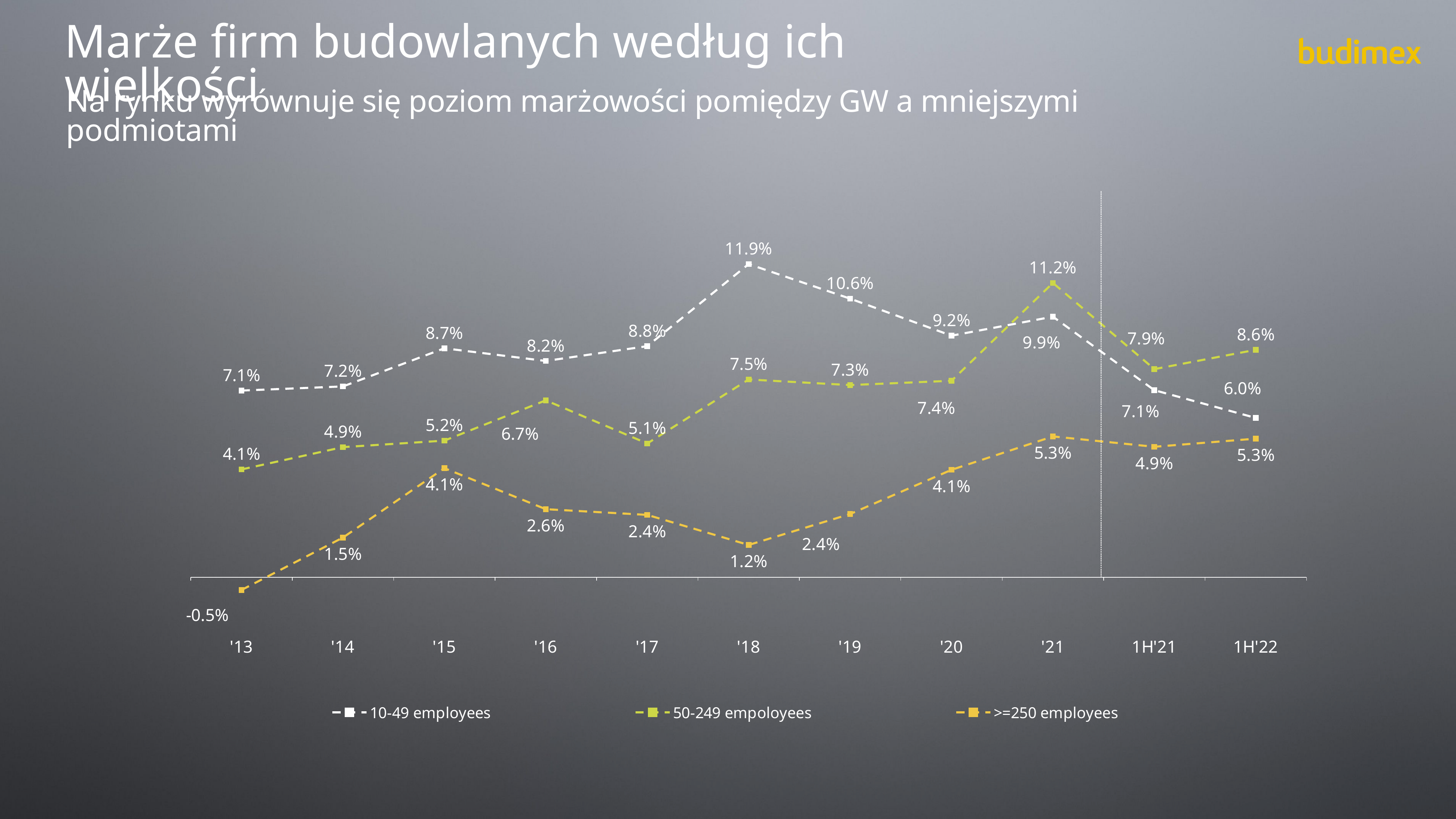
What is the value for 10-49 employees in '18? 11.9% What kind of chart is shown on the slide? Line chart What is the value for >=250 employees in '20? 4.1% In which period does the 50-249 empoloyees series reach its highest value? '21 In which period is the >=250 employees series at its lowest? '13 What is the value for >=250 employees in '13? -0.5% How many periods are shown on the x axis? 11 Which series has the higher value in '21: 10-49 employees or 50-249 empoloyees? 50-249 empoloyees How many series does the legend list? 3 Does the 10-49 employees series rise or fall from '21 to 1H'22? Fall What is the value for 50-249 empoloyees in 1H'22? 8.6% What is the difference between the 10-49 employees value and the >=250 employees value in '18? 10.7%